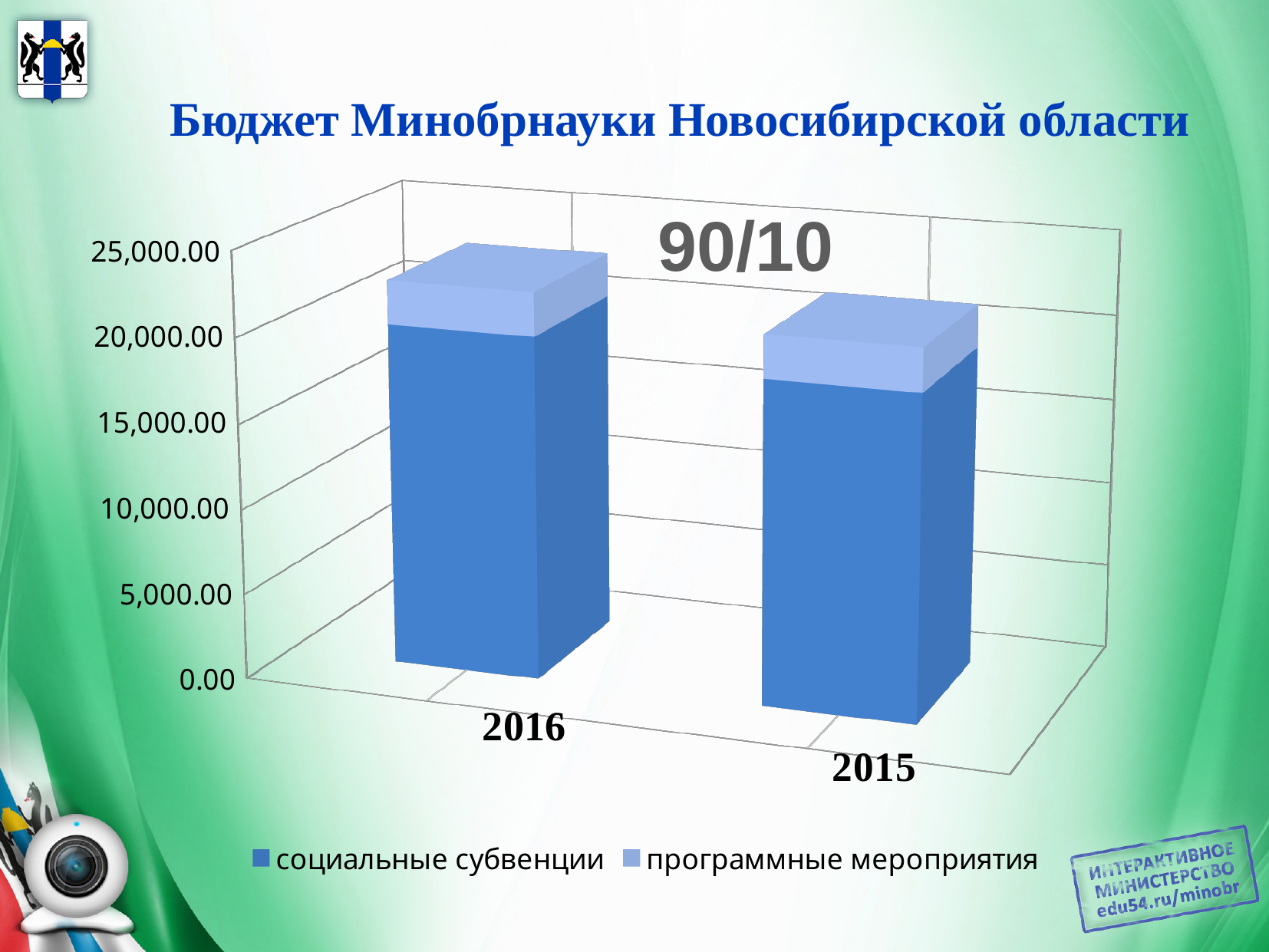
What kind of chart is shown on the slide? stacked bar chart Do the total bar heights rise or fall from left to right along the x axis? fall How many categories (years) are shown on the x axis of the chart? 2 Which year has the larger total budget bar, 2016 or 2015? 2016 Is the 'социальные субвенции' segment for 2015 greater or less than 10,000.00? greater Which year has the highest total bar in the chart? 2016 Is the total bar for 2015 greater or less than 15,000.00? greater Which year has the lowest total bar in the chart? 2015 Which year has the larger 'социальные субвенции' segment, 2016 or 2015? 2016 What is the title of the chart on the slide? Бюджет Минобрнауки Новосибирской области How many series does the chart legend list? 2 Is the total bar for 2016 greater or less than 20,000.00? greater